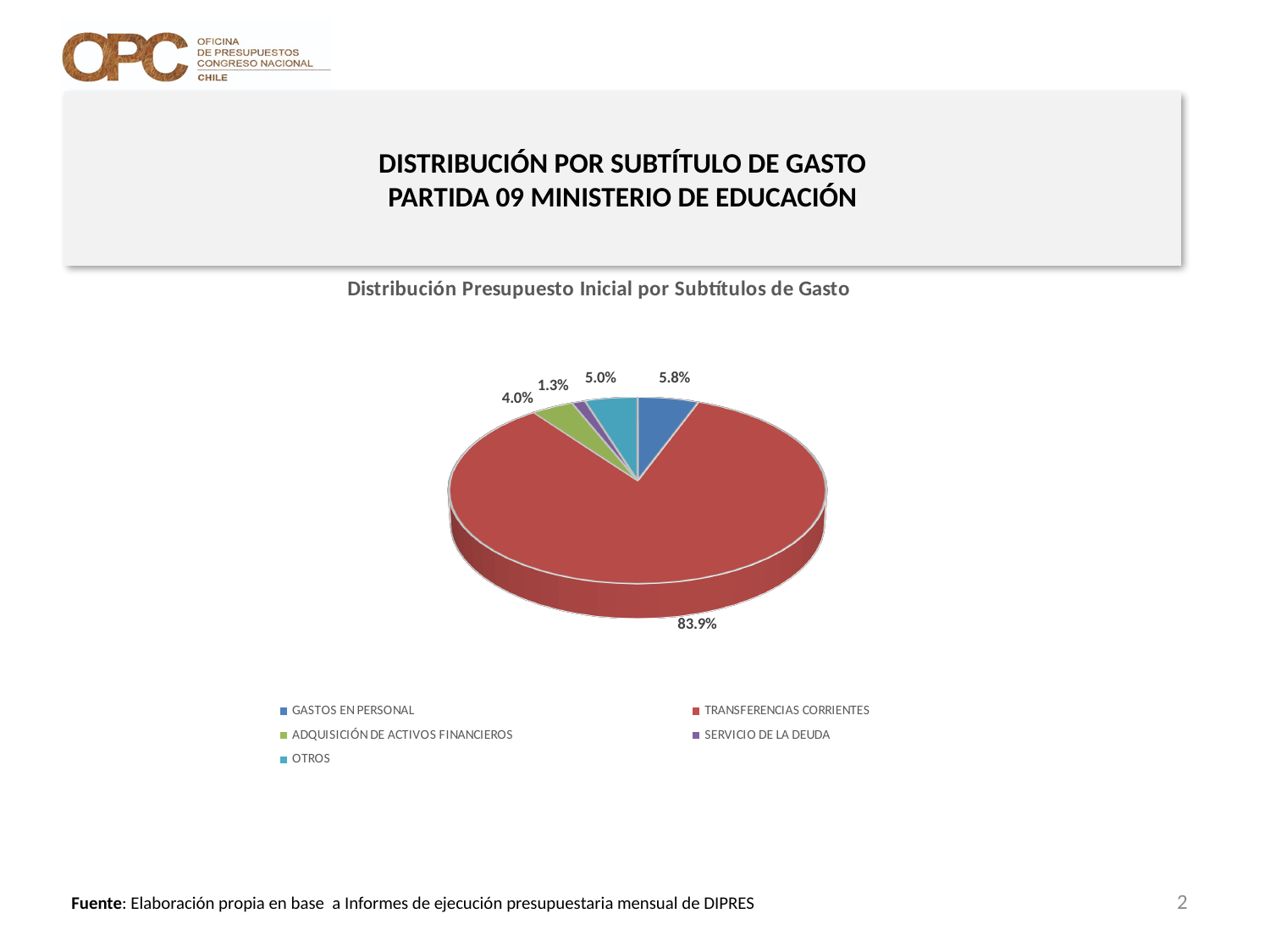
What share of the pie does SERVICIO DE LA DEUDA represent? 1.3% What share of the pie does ADQUISICIÓN DE ACTIVOS FINANCIEROS represent? 4.0% What share of the pie does TRANSFERENCIAS CORRIENTES represent? 83.9% What kind of chart is shown on the slide? pie chart Which is larger, the share for GASTOS EN PERSONAL or the share for OTROS? GASTOS EN PERSONAL What is the title of the chart? Distribución Presupuesto Inicial por Subtítulos de Gasto Which category has the smallest slice of the pie? SERVICIO DE LA DEUDA How many categories does the legend list? 5 What is the difference between the share for GASTOS EN PERSONAL and the share for ADQUISICIÓN DE ACTIVOS FINANCIEROS? 1.8% Which category has the largest slice of the pie? TRANSFERENCIAS CORRIENTES